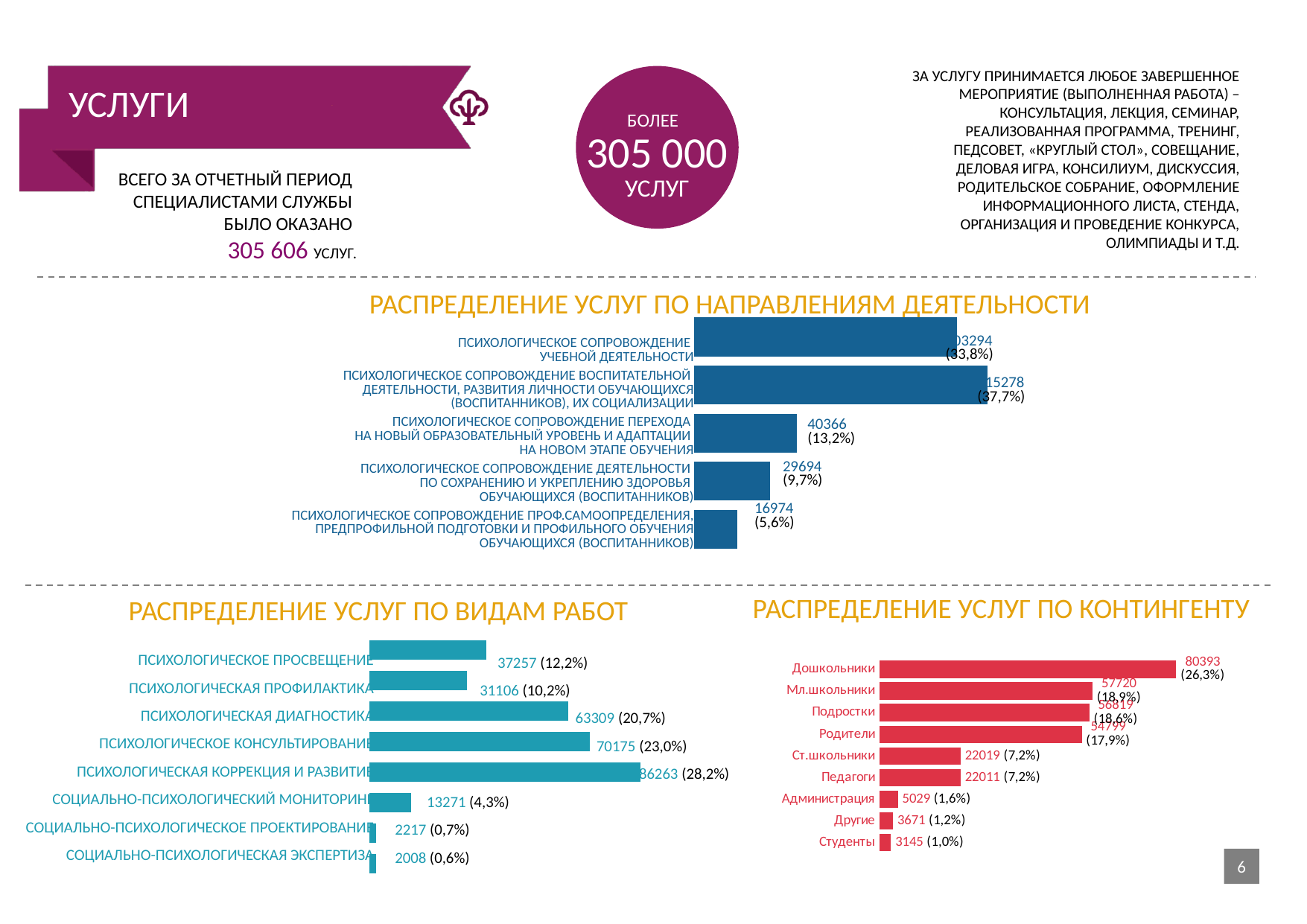
In the chart 'РАСПРЕДЕЛЕНИЕ УСЛУГ ПО КОНТИНГЕНТУ', which is larger: Дошкольники or Родители? Дошкольники In the chart 'РАСПРЕДЕЛЕНИЕ УСЛУГ ПО ВИДАМ РАБОТ', what is the value for ПСИХОЛОГИЧЕСКОЕ КОНСУЛЬТИРОВАНИЕ? 70175 (23,0%) In the chart 'РАСПРЕДЕЛЕНИЕ УСЛУГ ПО НАПРАВЛЕНИЯМ ДЕЯТЕЛЬНОСТИ', what is the value for ПСИХОЛОГИЧЕСКОЕ СОПРОВОЖДЕНИЕ ПЕРЕХОДА НА НОВЫЙ ОБРАЗОВАТЕЛЬНЫЙ УРОВЕНЬ И АДАПТАЦИИ НА НОВОМ ЭТАПЕ ОБУЧЕНИЯ? 40366 (13,2%) In the chart 'РАСПРЕДЕЛЕНИЕ УСЛУГ ПО КОНТИНГЕНТУ', how many categories are shown? 9 What type of chart is 'РАСПРЕДЕЛЕНИЕ УСЛУГ ПО НАПРАВЛЕНИЯМ ДЕЯТЕЛЬНОСТИ'? Bar chart In the chart 'РАСПРЕДЕЛЕНИЕ УСЛУГ ПО ВИДАМ РАБОТ', which category has the lowest value? СОЦИАЛЬНО-ПСИХОЛОГИЧЕСКАЯ ЭКСПЕРТИЗА In the chart 'РАСПРЕДЕЛЕНИЕ УСЛУГ ПО КОНТИНГЕНТУ', which category has the lowest value? Студенты In the chart 'РАСПРЕДЕЛЕНИЕ УСЛУГ ПО КОНТИНГЕНТУ', what is the value for Дошкольники? 80393 (26,3%) In the chart 'РАСПРЕДЕЛЕНИЕ УСЛУГ ПО ВИДАМ РАБОТ', which category has the highest value? ПСИХОЛОГИЧЕСКАЯ КОРРЕКЦИЯ И РАЗВИТИЕ In the chart 'РАСПРЕДЕЛЕНИЕ УСЛУГ ПО ВИДАМ РАБОТ', what is the difference between ПСИХОЛОГИЧЕСКАЯ ДИАГНОСТИКА and ПСИХОЛОГИЧЕСКАЯ ПРОФИЛАКТИКА? 32203 In the chart 'РАСПРЕДЕЛЕНИЕ УСЛУГ ПО ВИДАМ РАБОТ', how many categories are shown? 8 In the chart 'РАСПРЕДЕЛЕНИЕ УСЛУГ ПО КОНТИНГЕНТУ', what is the value for Администрация? 5029 (1,6%)